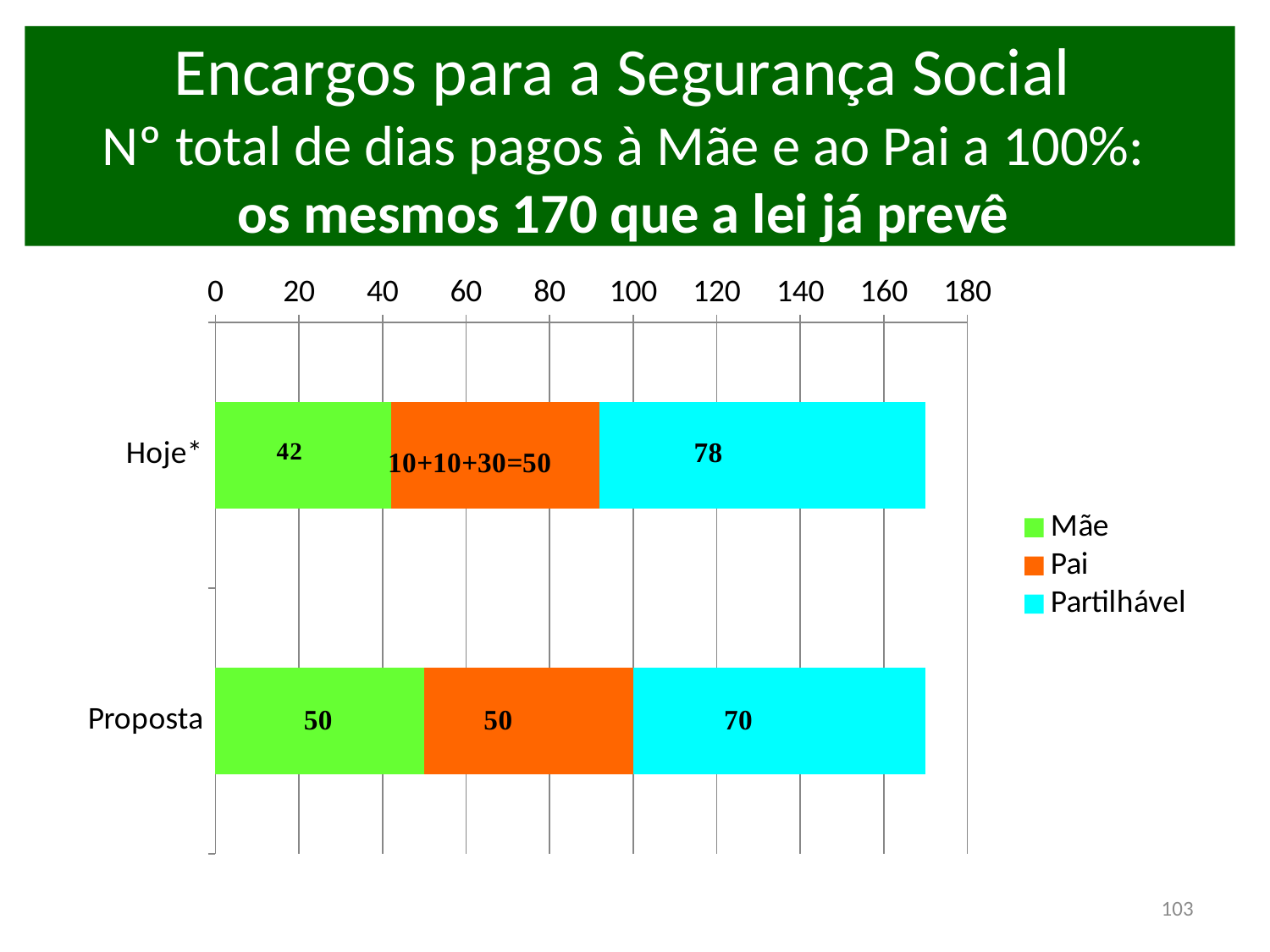
What label is printed on the Pai segment of the Hoje* bar? 10+10+30=50 What is the value for Mãe in the Hoje* bar? 42 How many series does the legend list? 3 What is the value for Mãe in the Proposta bar? 50 What is the total of the Hoje* stacked bar? 170 What is the total of the Proposta stacked bar? 170 What kind of chart is shown on the slide? Stacked bar chart What is the value for Partilhável in the Proposta bar? 70 What is the value for Partilhável in the Hoje* bar? 78 What is the difference between the Partilhável values for Hoje* and Proposta? 8 How many categories are shown on the chart? 2 Which is larger, the Mãe value for Hoje* or the Mãe value for Proposta? Proposta